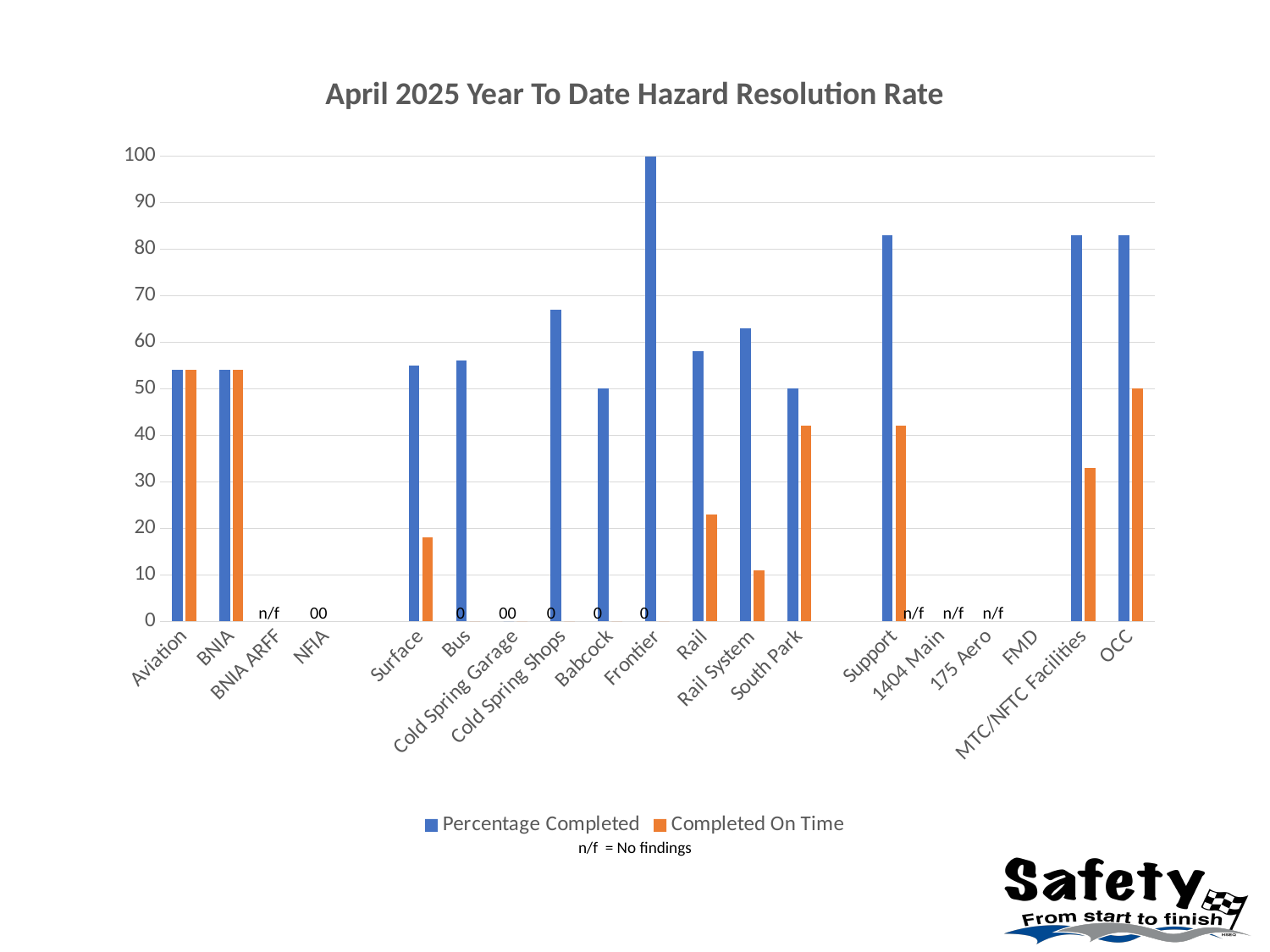
Is the Percentage Completed value for Cold Spring Shops greater or less than 60? greater According to the note below the legend, what does n/f stand for? No findings Which has the larger Percentage Completed value, Frontier or Bus? Frontier Which category has the highest Percentage Completed? Frontier How many categories are shown along the x axis? 19 What kind of chart is shown on the slide? bar chart Is the Completed On Time value for Surface greater or less than 20? less Is the Percentage Completed value for Support greater or less than 80? greater Which has the larger Completed On Time value, Aviation or Surface? Aviation What is the Completed On Time value for Babcock? 0 What is the Percentage Completed value for Frontier? 100 How many series does the legend list? 2